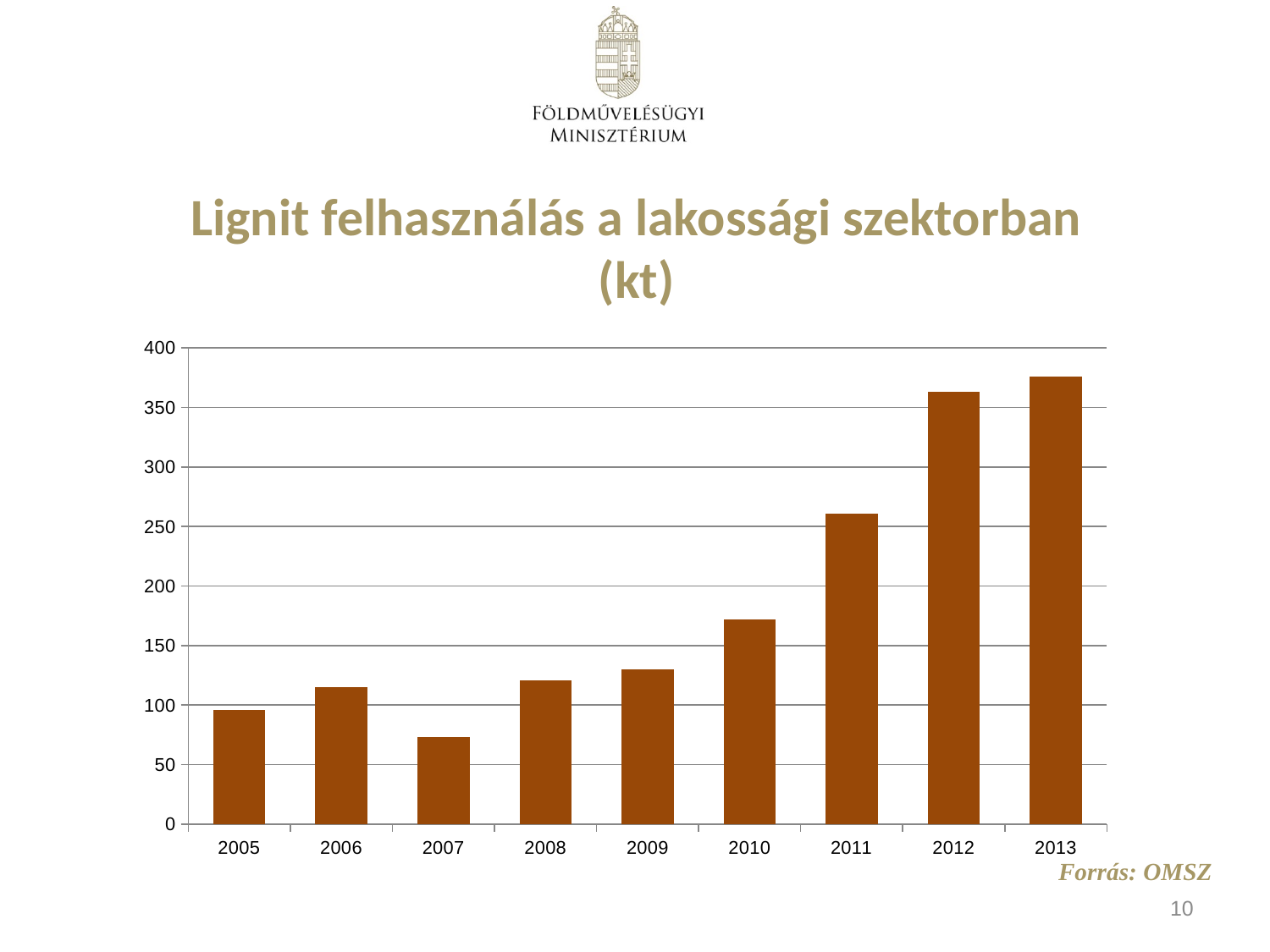
What is the title of the chart on the slide? Lignit felhasználás a lakossági szektorban (kt) Is the value for 2013 greater or less than 400? less How many years are shown on the x axis of the chart? 9 Which is larger, the value for 2010 or the value for 2011? 2011 Is the value for 2010 greater or less than 200? less Is the value for 2011 greater or less than 250? greater What kind of chart is shown on the slide? bar chart Which year has the lowest lignite consumption in the chart? 2007 Do the values generally rise or fall from 2007 to 2013? rise